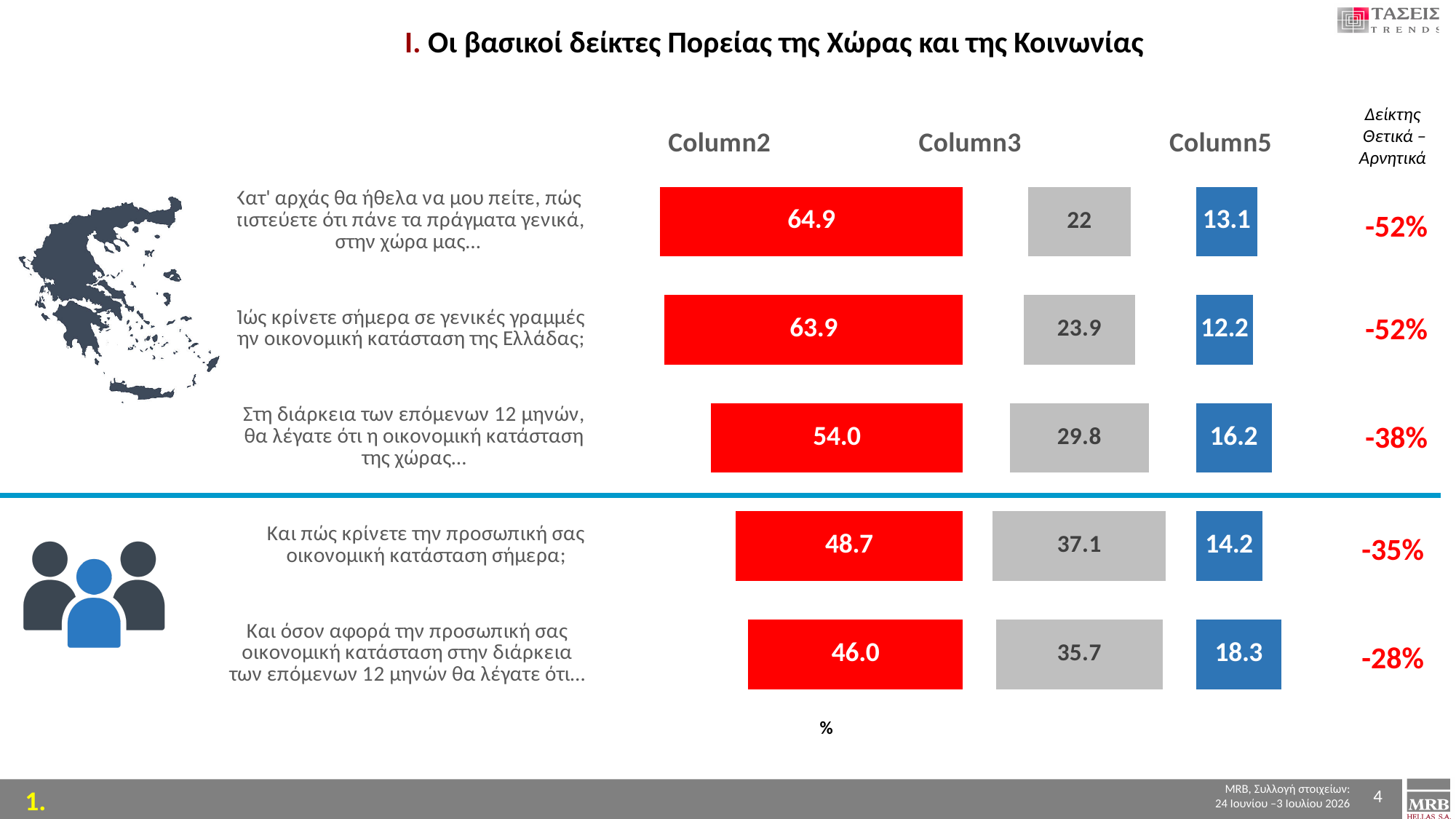
How many series does the chart show (Column2, Column3, Column5)? 3 What is the total of the stacked bar for the first question (64.9 + 22 + 13.1)? 100 What is the Δείκτης Θετικά – Αρνητικά value for the question about the country's economic situation over the next 12 months? -38% What is the Column5 value for the question about personal economic situation over the next 12 months? 18.3 Which question has the lowest Column5 value? Πώς κρίνετε σήμερα σε γενικές γραμμές την οικονομική κατάσταση της Ελλάδας; What is the Column2 value for the question about how things are going generally in the country ("πώς πιστεύετε ότι πάνε τα πράγματα γενικά, στην χώρα μας")? 64.9 Which question has the highest Column2 value? Κατ' αρχάς θα ήθελα να μου πείτε, πώς πιστεύετε ότι πάνε τα πράγματα γενικά, στην χώρα μας... How many questions (categories) are shown in the chart? 5 Which has the larger Column3 value: the question about personal economic situation today or the question about the country's economic situation over the next 12 months? Personal economic situation today (37.1) What is the difference between the Column2 value for the first question (64.9) and the Column2 value for the last question about personal economic situation in the next 12 months (46.0)? 18.9 What is the Column3 value for "Πώς κρίνετε σήμερα σε γενικές γραμμές την οικονομική κατάσταση της Ελλάδας;"? 23.9 What kind of chart is shown on the slide? Stacked bar chart